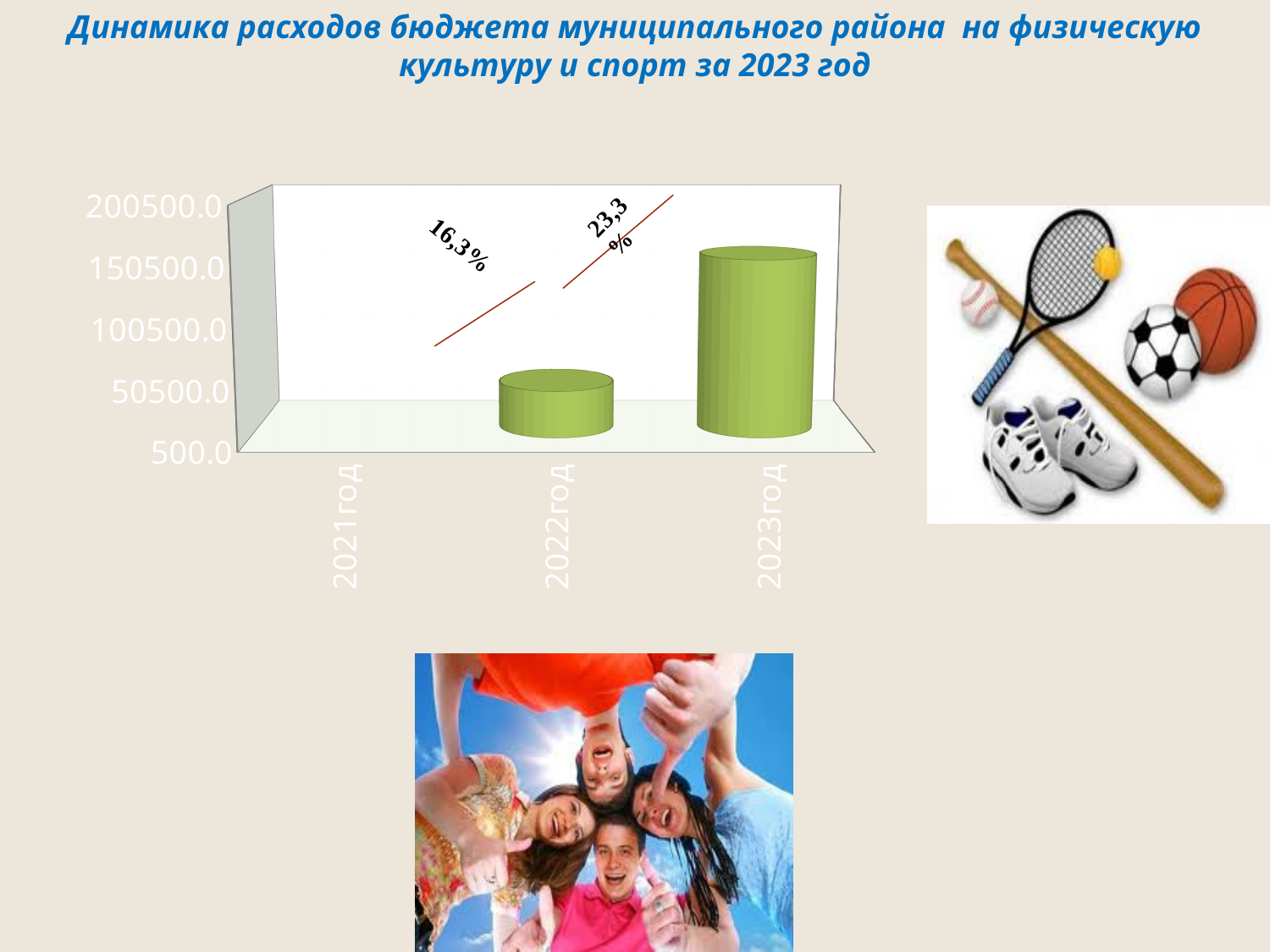
Is the value for 2023год greater or less than 200500.0? less Is the value for 2022год greater or less than 100500.0? less Which year has the highest value in the chart? 2023год Do the values rise or fall from 2021год to 2023год? rise Is the value for 2023год greater or less than 100500.0? greater Which year has the lowest value in the chart? 2021год What kind of chart is shown on the slide? bar chart What is the highest tick value shown on the vertical axis of the chart? 200500.0 How many categories (years) are shown on the x axis of the chart? 3 Which is larger, the value for 2022год or the value for 2023год? 2023год